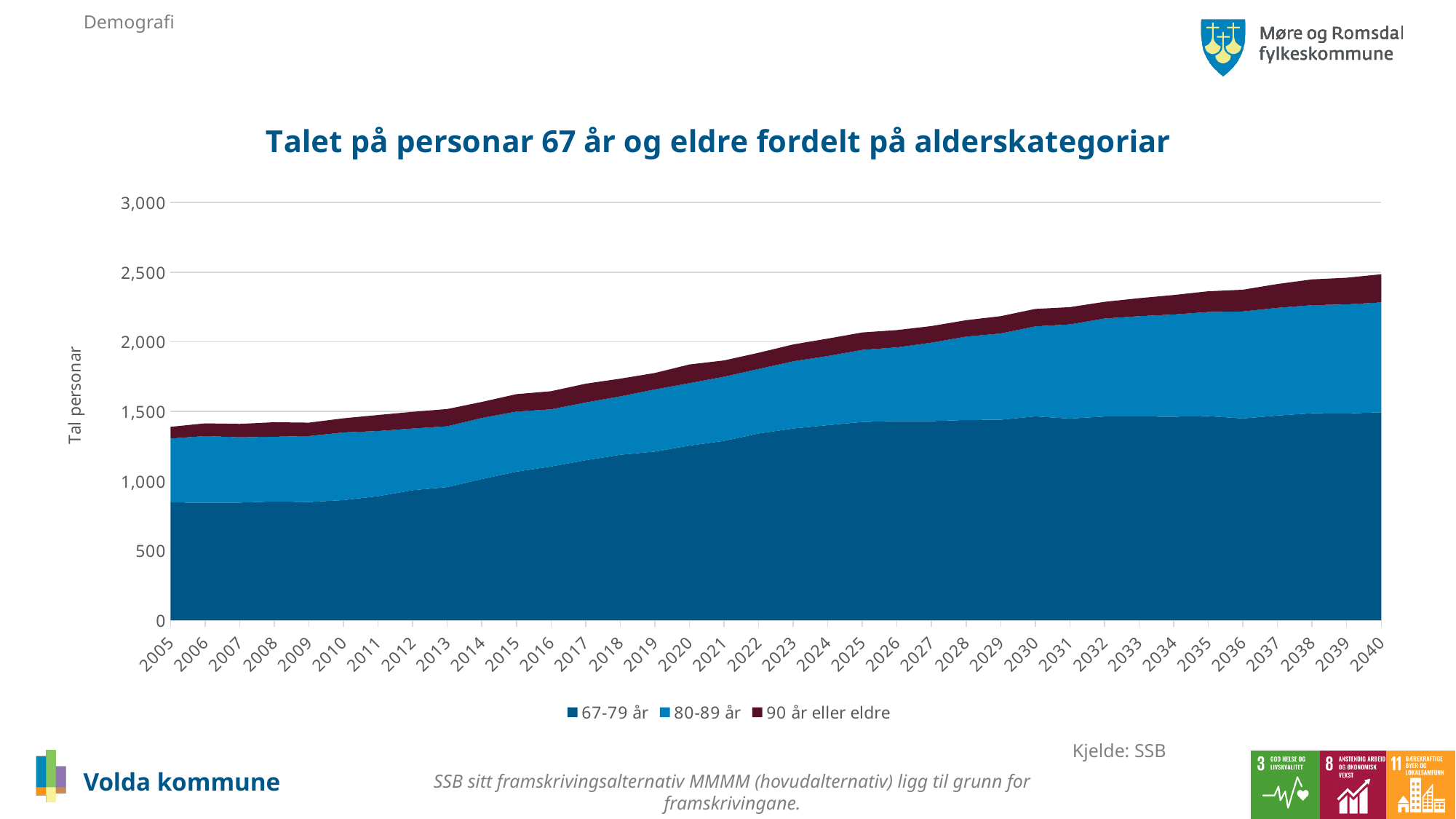
How many years are shown along the x axis? 36 How many series does the legend list? 3 Is the total for all age categories in 2005 greater or less than 1,500? less What kind of chart is shown on the slide? Stacked area chart Is the value for 67-79 år in 2040 greater or less than 1,000? greater In 2040, which is larger: the value for 67-79 år or the value for 80-89 år? 67-79 år Which age category has the smallest value in 2040? 90 år eller eldre Is the total for all age categories in 2040 greater or less than 2,000? greater Which age category has the largest value in 2040? 67-79 år What is the label on the y axis of the chart? Tal personar Does the total number of persons 67 år og eldre rise or fall from 2005 to 2040? Rise